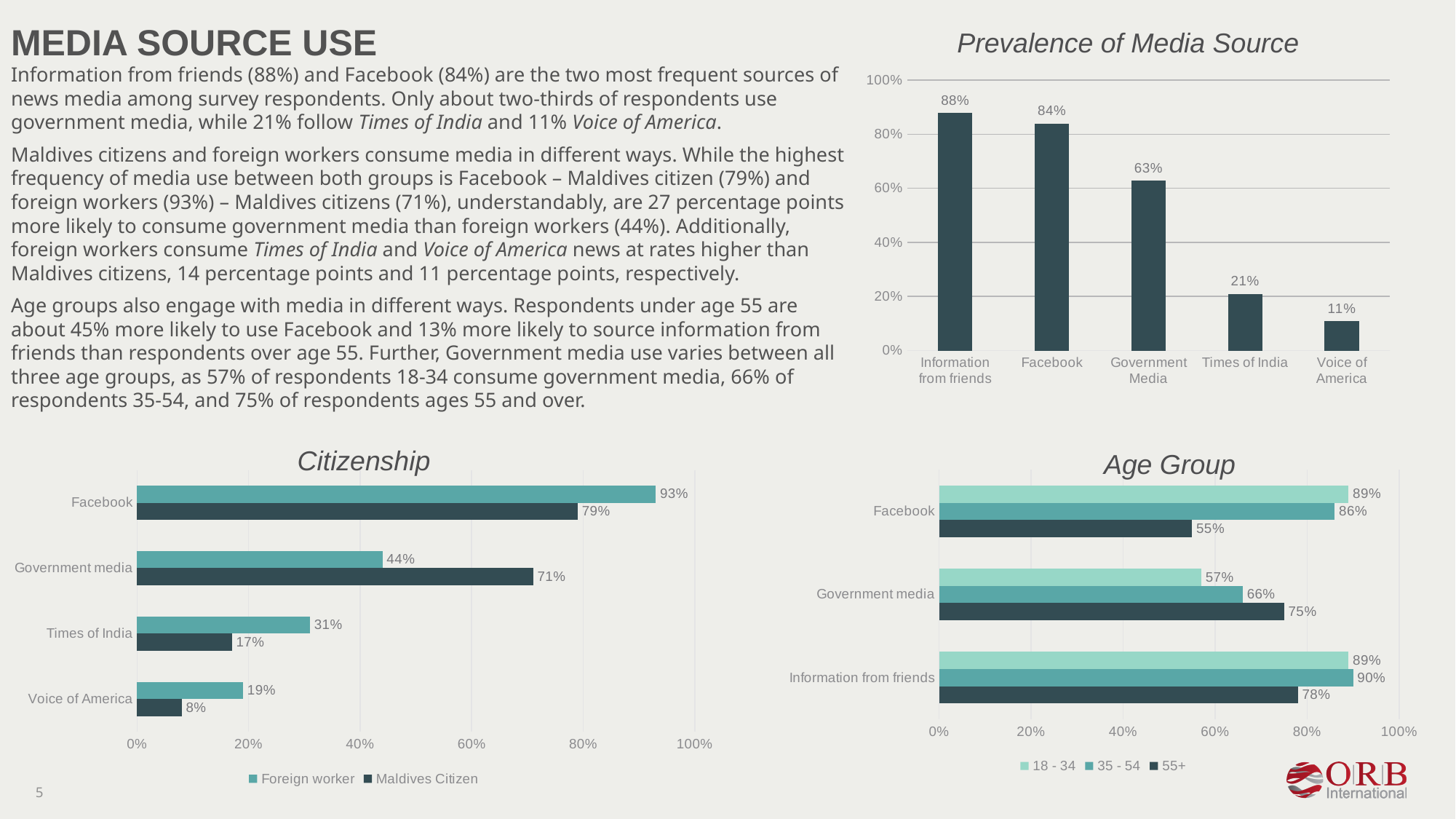
In the 'Citizenship' chart, what is the value for Maldives Citizen for Government media? 71% In the 'Prevalence of Media Source' chart, which media source has the lowest value? Voice of America How many series does the legend of the 'Age Group' chart list? 3 How many categories are shown in the 'Prevalence of Media Source' chart? 5 In the 'Citizenship' chart, what is the difference between Foreign worker and Maldives Citizen for Voice of America? 11 percentage points In the 'Prevalence of Media Source' chart, what is the value for Government Media? 63% What type of chart is the 'Age Group' chart? Bar chart In the 'Age Group' chart, what is the value for the 55+ group for Facebook? 55% In the 'Citizenship' chart, which is larger for Times of India: Foreign worker or Maldives Citizen? Foreign worker How many series does the legend of the 'Citizenship' chart list? 2 In the 'Age Group' chart, which age group has the highest value for Government media? 55+ In the 'Prevalence of Media Source' chart, what is the difference between Information from friends and Facebook? 4 percentage points